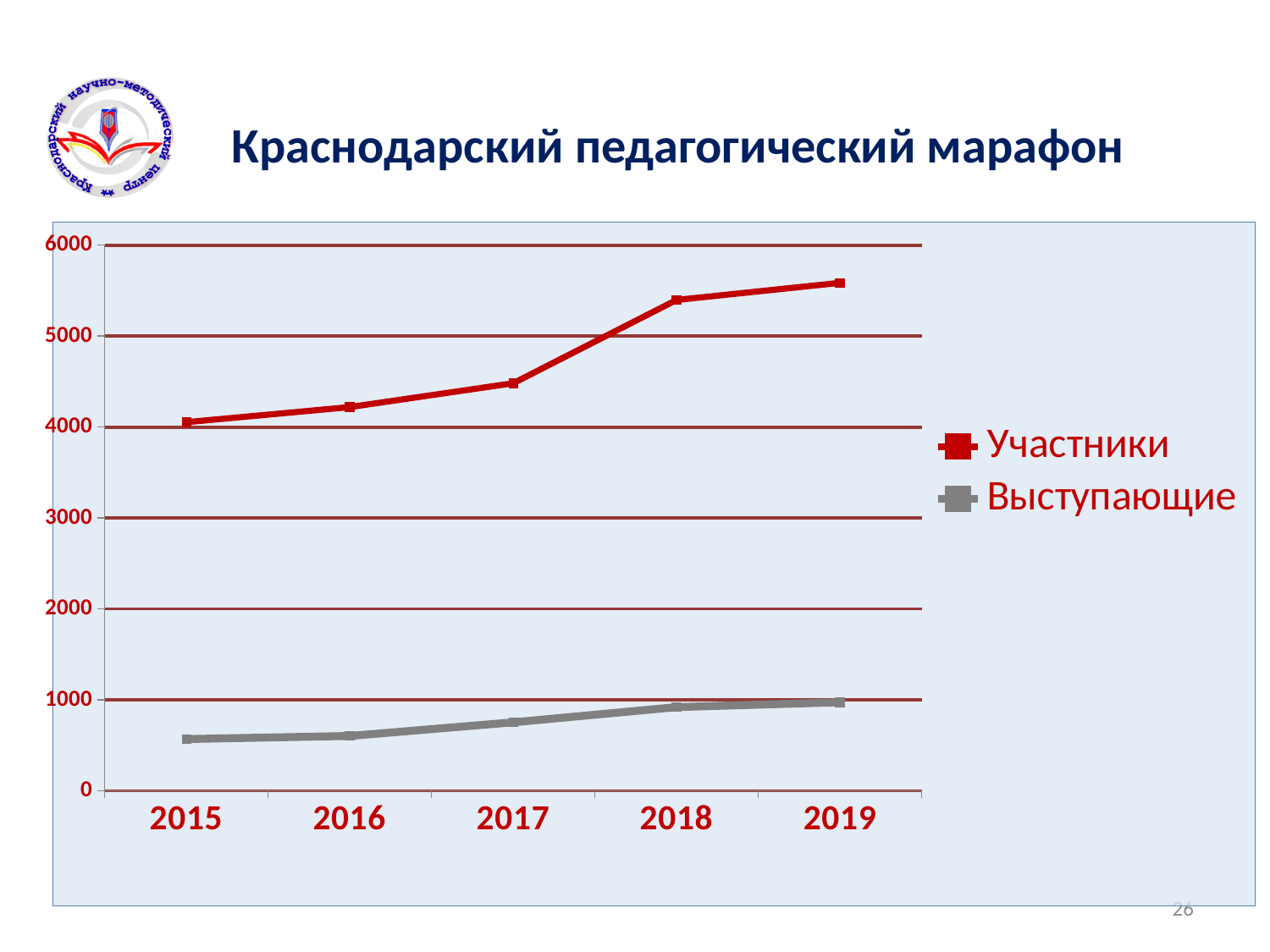
In which year is the value for Участники lowest? 2015 Is the value for Выступающие in 2015 greater or less than 1000? less How many years are shown on the x axis? 5 Is the value for Участники in 2017 greater or less than 5000? less What is the title of the slide? Краснодарский педагогический марафон Do the values for Участники rise or fall from 2015 to 2019? rise Which is larger for Участники: the value in 2017 or the value in 2018? 2018 In which year is the value for Участники highest? 2019 Which series is drawn in red? Участники How many series does the legend list? 2 What kind of chart is shown on the slide? line chart